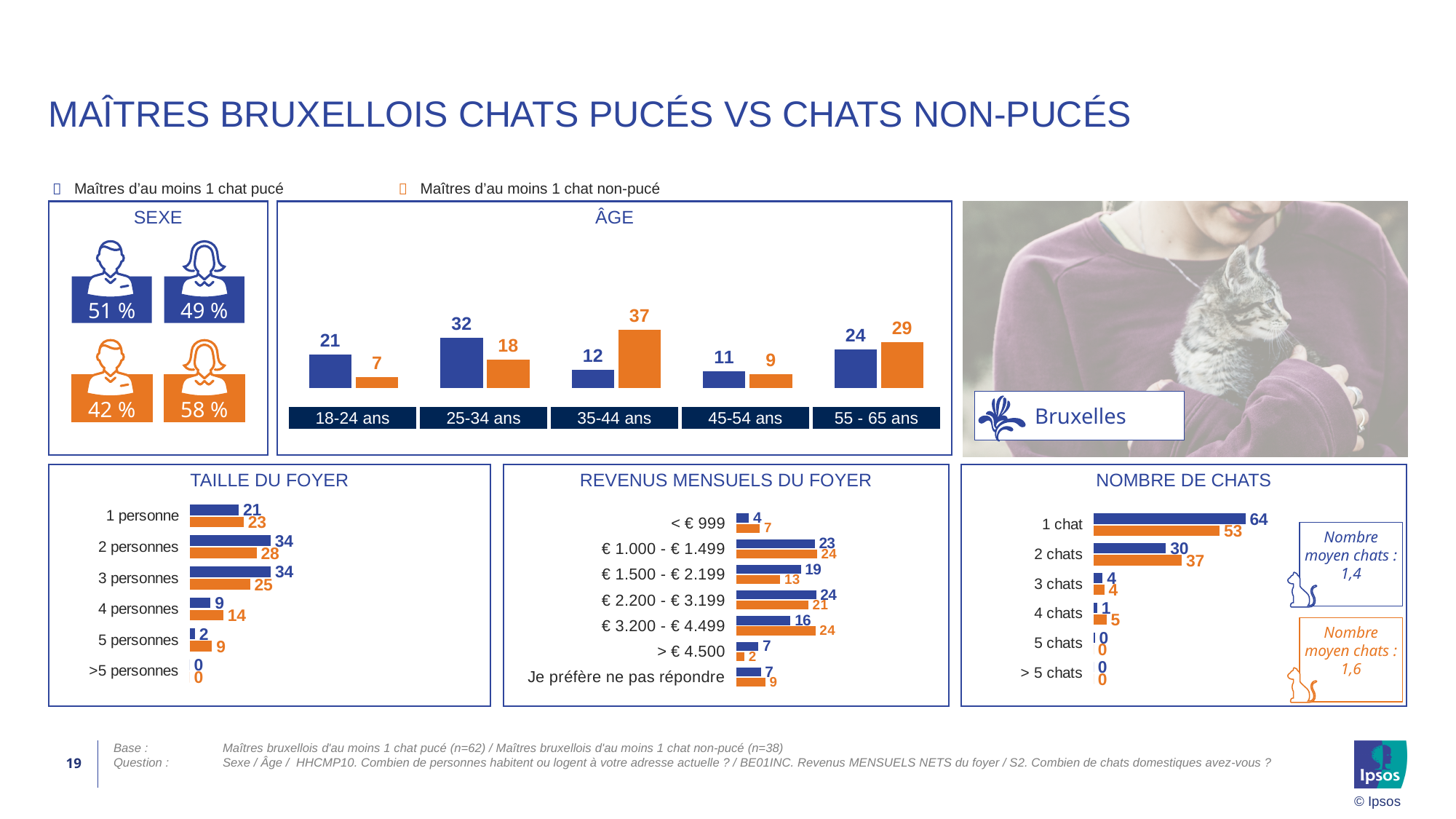
In the REVENUS MENSUELS DU FOYER chart, what is the value for € 2.200 - € 3.199 for Maîtres d'au moins 1 chat pucé? 24 In the ÂGE chart, how many age groups are shown? 5 In the REVENUS MENSUELS DU FOYER chart, how many income categories are listed? 7 In the ÂGE chart, what is the difference between the two series for 18-24 ans? 14 In the REVENUS MENSUELS DU FOYER chart, which series has the larger value for € 3.200 - € 4.499? Maîtres d'au moins 1 chat non-pucé How many series does the legend at the top of the slide list? 2 What type of chart is the NOMBRE DE CHATS chart? Bar chart In the TAILLE DU FOYER chart, which category has the lowest value for Maîtres d'au moins 1 chat pucé? >5 personnes In the NOMBRE DE CHATS chart, what is the difference between the two series for 1 chat? 11 In the TAILLE DU FOYER chart, what is the value for 4 personnes for Maîtres d'au moins 1 chat non-pucé? 14 In the ÂGE chart, which age group has the highest value for Maîtres d'au moins 1 chat pucé? 25-34 ans In the ÂGE chart, what is the value for 35-44 ans for Maîtres d'au moins 1 chat non-pucé? 37